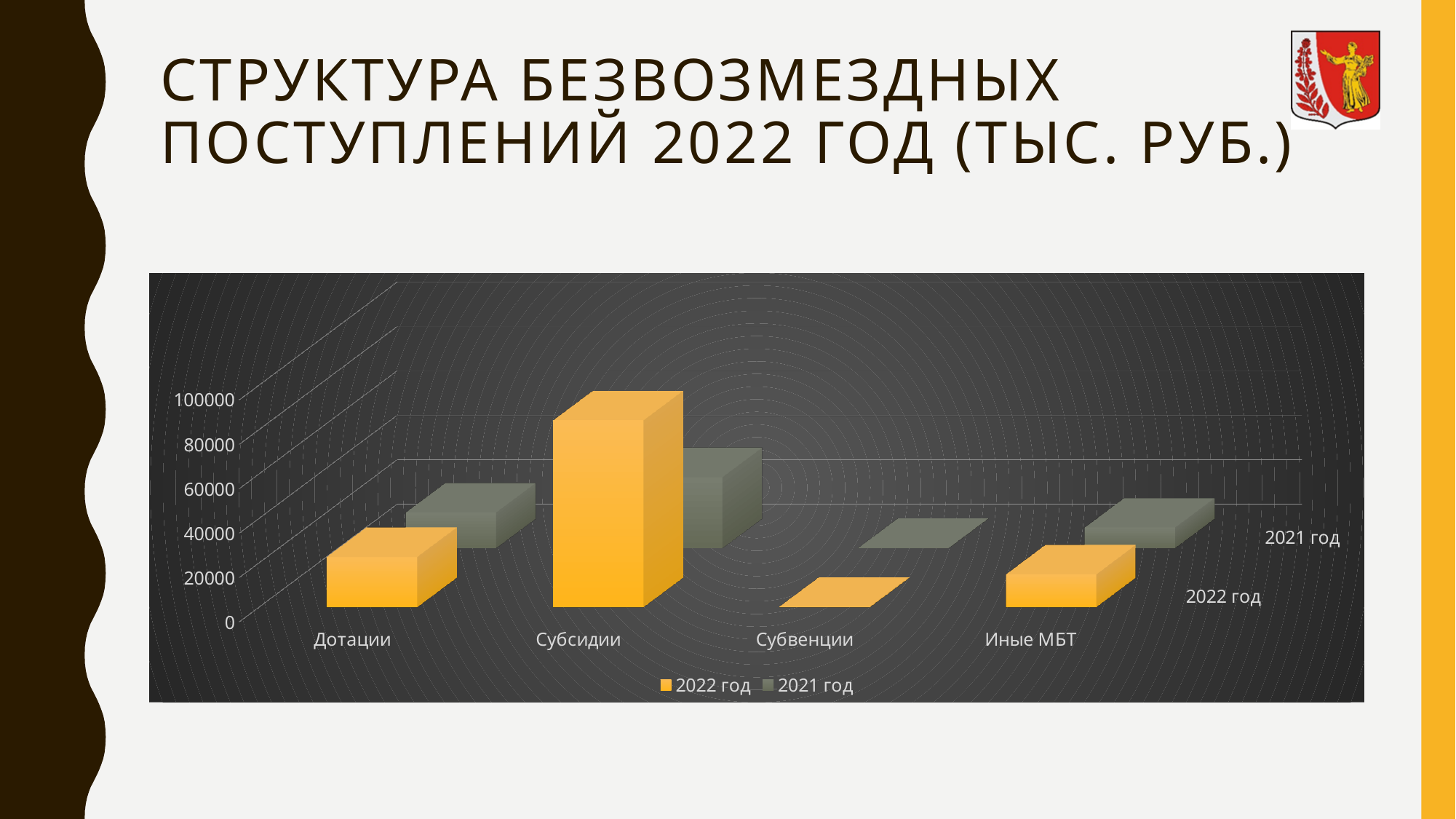
Is the 2022 год value for Субсидии greater or less than 60000? greater Which category has the highest value for the 2022 год series? Субсидии Is the 2022 год value for Субвенции greater or less than 20000? less Which is larger for Субсидии: the 2022 год value or the 2021 год value? 2022 год Which category has the lowest value for the 2021 год series? Субвенции Which category has the lowest value for the 2022 год series? Субвенции How many categories are shown on the x axis of the chart? 4 What are the two series listed in the chart legend? 2022 год and 2021 год Is the 2022 год value for Дотации greater or less than 60000? less What kind of chart is shown on the slide? bar chart How many series does the chart legend list? 2 Which category has the highest value for the 2021 год series? Субсидии